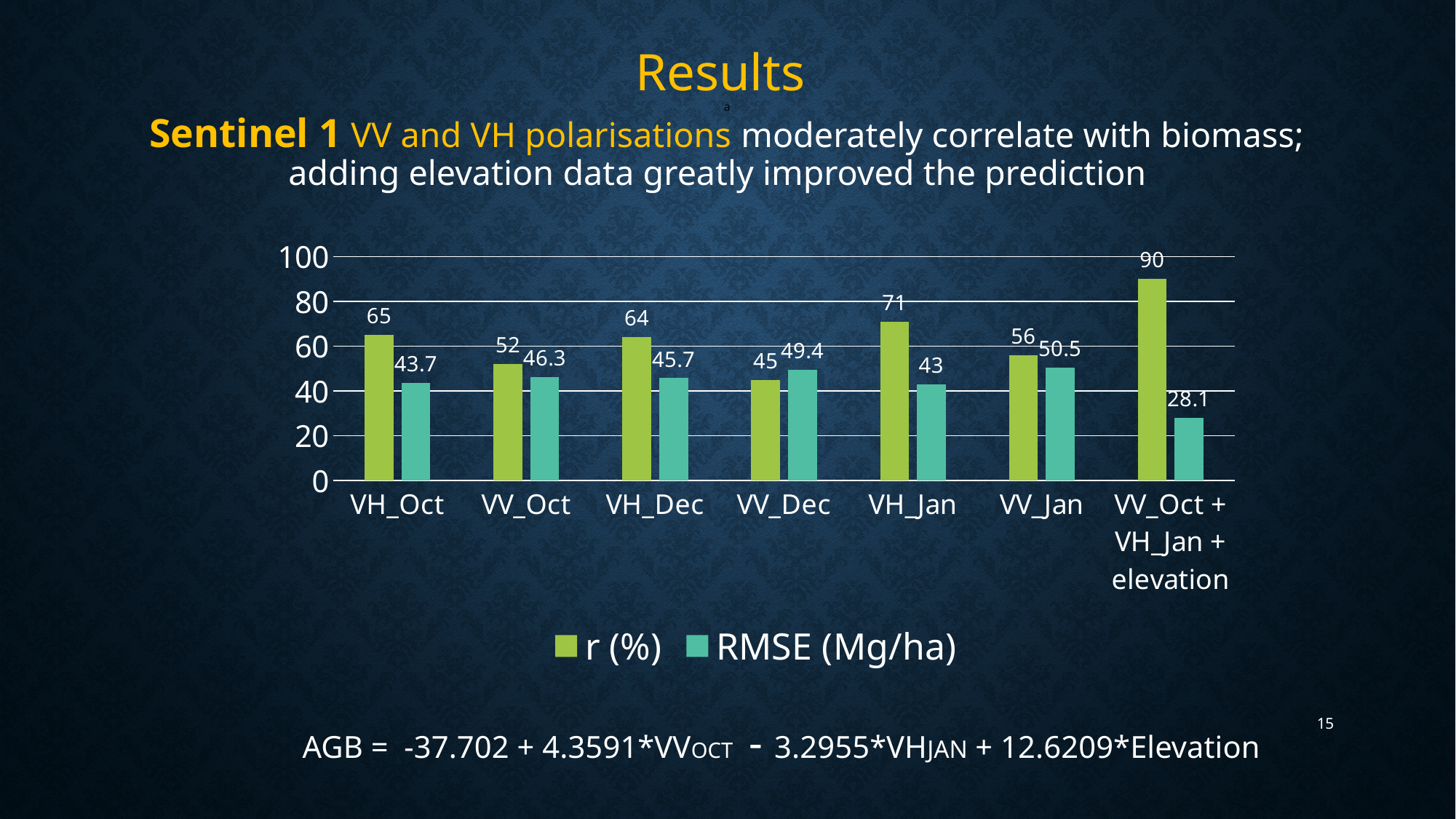
What is the difference between the r (%) values for VH_Oct and VV_Oct? 13 Which is larger, the RMSE (Mg/ha) for VH_Dec or for VV_Oct? VV_Oct How many series does the legend list? 2 Is the r (%) value for VH_Dec greater or less than 60? greater Which category has the lowest r (%) value? VV_Dec What is the RMSE (Mg/ha) value for VV_Dec? 49.4 What is the r (%) value for VH_Jan? 71 Which category has the highest RMSE (Mg/ha) value? VV_Jan Which category has the highest r (%) value? VV_Oct + VH_Jan + elevation How many categories are shown on the x axis? 7 What kind of chart is shown on the slide? bar chart What is the RMSE (Mg/ha) value for VV_Oct + VH_Jan + elevation? 28.1